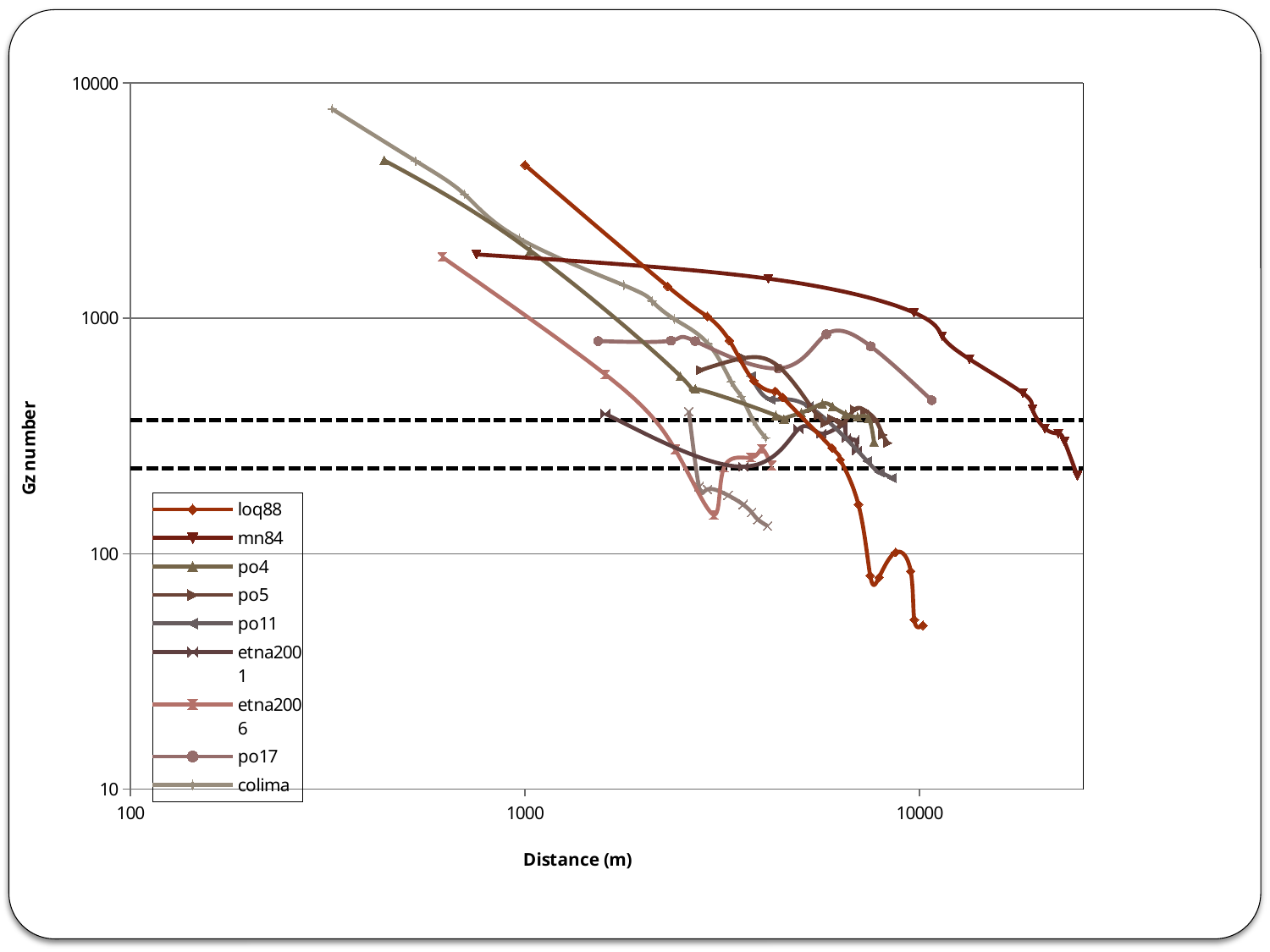
Is the Gz number for mn84 at a distance of 20000 m greater or less than 1000? less Is the highest Gz number of the colima series greater or less than 1000? greater What is the title of the y axis? Gz number Does the Gz number for the mn84 series rise or fall as distance increases? fall Which series reaches the largest distance on the x axis? mn84 How many series does the legend list? 9 What is the title of the x axis? Distance (m) Is the lowest Gz number reached by the loq88 series greater or less than 100? less At a distance of 1000 m, which series has the larger Gz number, loq88 or mn84? loq88 What kind of chart is shown on the slide? line chart Which series reaches the lowest Gz number on the chart? loq88